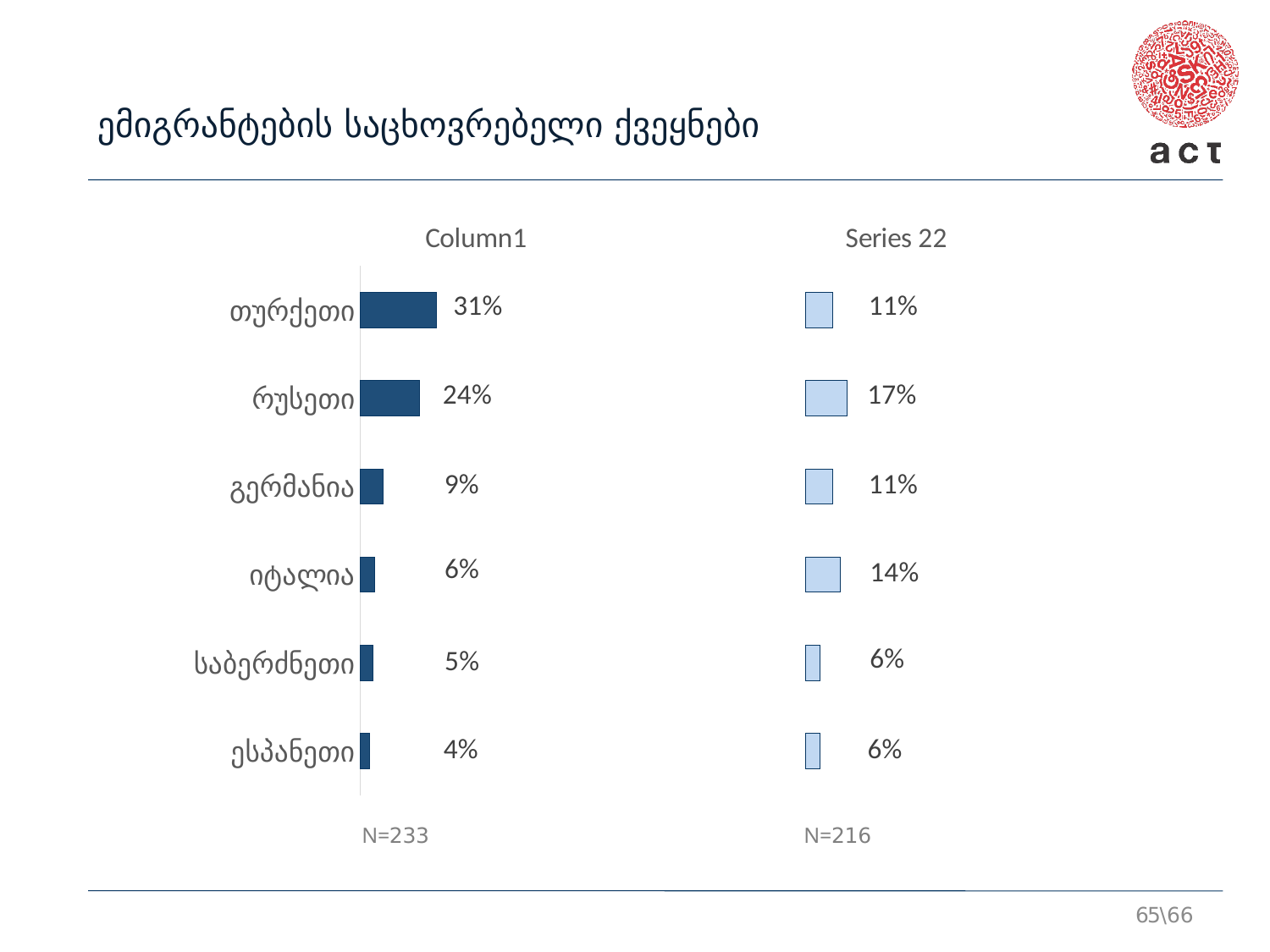
What is the Series 22 value for იტალია? 14% Which category has the highest Series 22 value? რუსეთი What is the Column1 value for გერმანია? 9% How many categories are shown in the chart? 6 What is the Column1 value for თურქეთი? 31% What kind of chart is shown on the slide? bar chart What is the Series 22 value for რუსეთი? 17% Which category has the lowest Column1 value? ესპანეთი How many series does the chart show? 2 Which category has the highest Column1 value? თურქეთი Which is larger for იტალია: the Column1 value or the Series 22 value? Series 22 What is the difference between the Column1 values for თურქეთი and რუსეთი? 7%